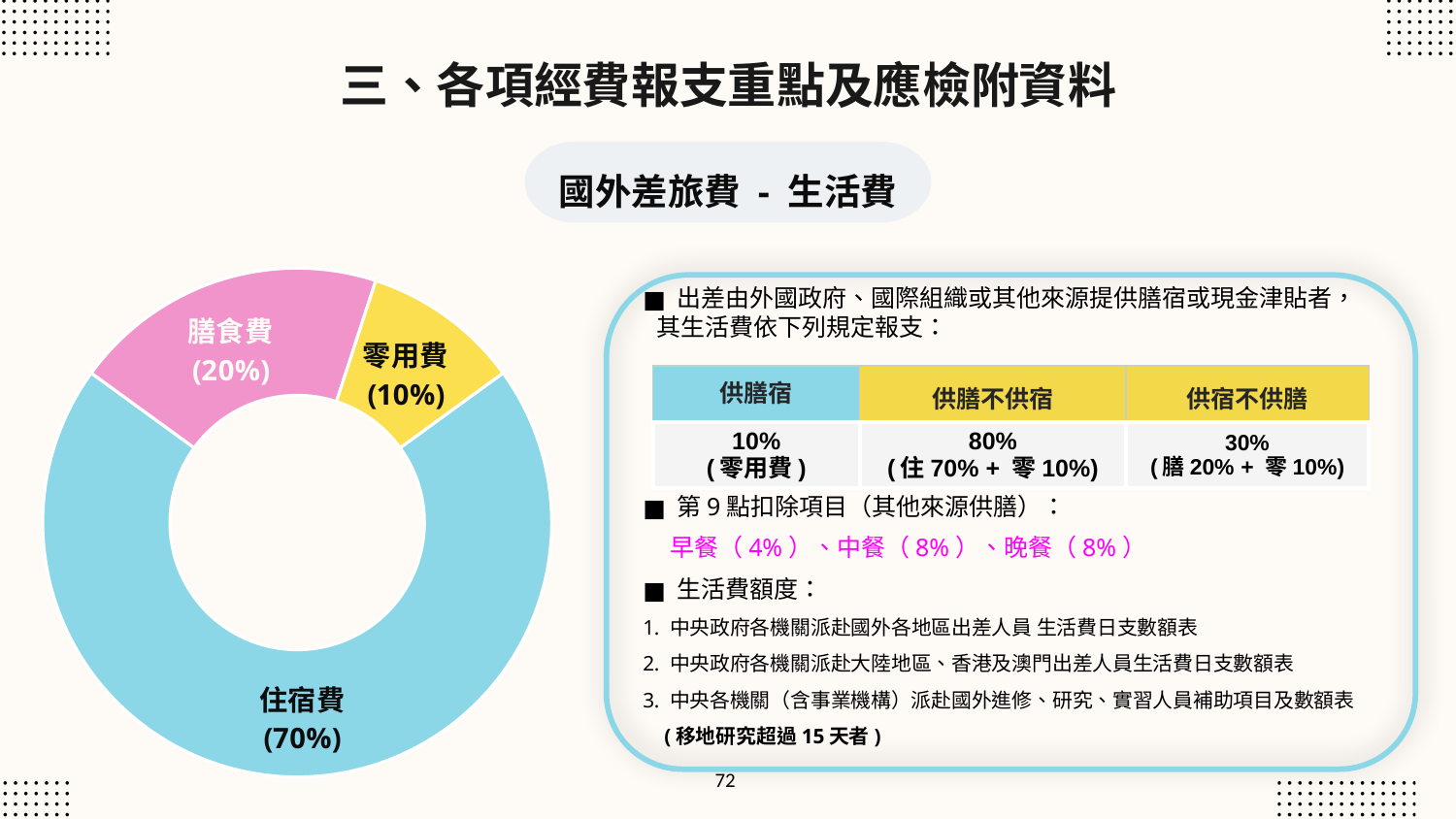
What kind of chart is shown on the left of the slide? Donut (pie) chart Which category has the largest slice in the donut chart? 住宿費 What share of the donut chart is 住宿費? 70% How many slices does the donut chart have? 3 Which category has the smallest slice in the donut chart? 零用費 What is the difference between the 膳食費 share and the 零用費 share in the donut chart? 10% What colour is the 零用費 slice in the donut chart? Yellow What share of the donut chart is 膳食費? 20% What share of the donut chart is 零用費? 10% Which is larger in the donut chart, 膳食費 or 零用費? 膳食費 What is the difference between the 住宿費 share and the 膳食費 share in the donut chart? 50% What colour is the 住宿費 slice in the donut chart? Light blue